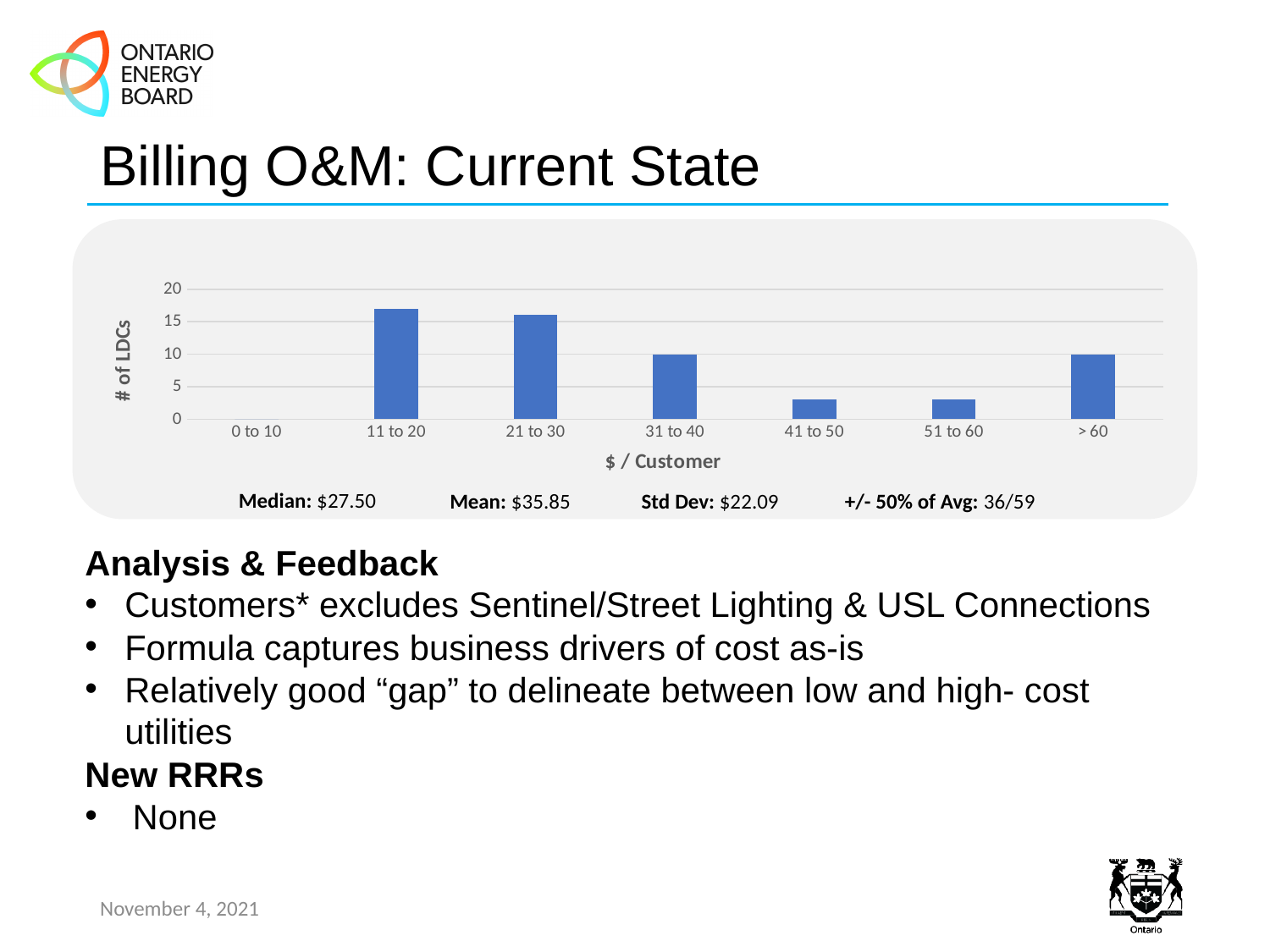
What kind of chart is shown on the slide? bar chart Do the number of LDCs rise or fall along the x axis from the 11 to 20 category through the 51 to 60 category? fall Is the number of LDCs for the 11 to 20 category greater or less than 15? greater Is the number of LDCs for the 41 to 50 category greater or less than 5? less Is the number of LDCs for the 51 to 60 category greater or less than 5? less What is the title of the vertical axis of the chart? # of LDCs Which $ / Customer category has the highest number of LDCs? 11 to 20 Which $ / Customer category has the lowest number of LDCs? 0 to 10 How many $ / Customer categories are shown on the x axis of the chart? 7 Which has more LDCs, the 11 to 20 category or the 31 to 40 category? 11 to 20 Which has more LDCs, the > 60 category or the 41 to 50 category? > 60